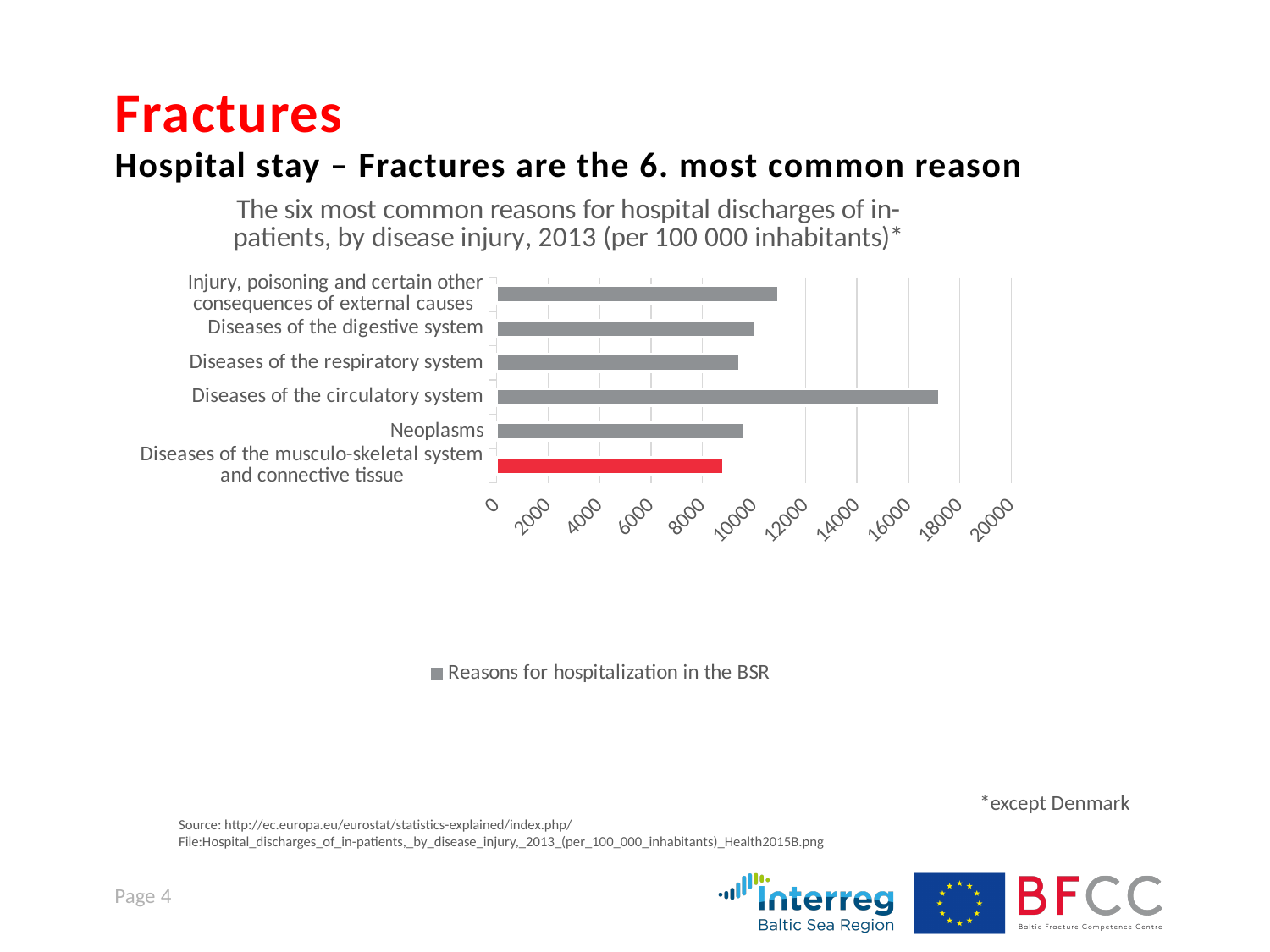
How many series does the chart legend list? 1 Which is larger: the value for Injury, poisoning and certain other consequences of external causes or the value for Diseases of the musculo-skeletal system and connective tissue? Injury, poisoning and certain other consequences of external causes Which category's bar is coloured red in the chart? Diseases of the musculo-skeletal system and connective tissue What kind of chart is shown on the slide? bar chart Is the value for Injury, poisoning and certain other consequences of external causes greater or less than 10000? greater Is the value for Diseases of the respiratory system greater or less than 10000? less How many categories (reasons) are plotted in the chart? 6 Which is larger: the value for Diseases of the circulatory system or the value for Neoplasms? Diseases of the circulatory system Is the value for Diseases of the musculo-skeletal system and connective tissue greater or less than 10000? less What is the legend entry shown below the chart? Reasons for hospitalization in the BSR Which category has the highest value in the chart? Diseases of the circulatory system